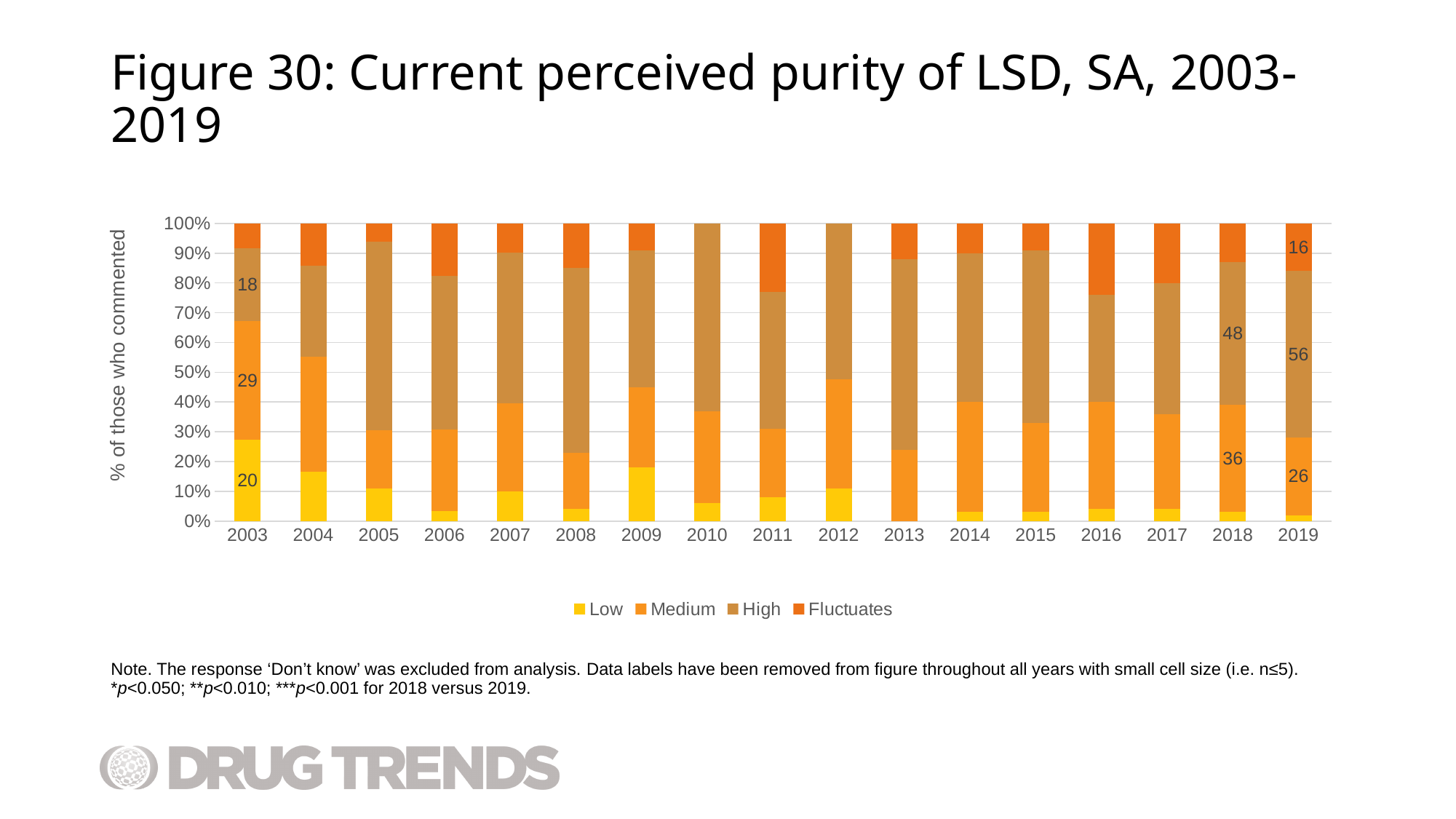
What is the data label on the Medium segment for 2018? 36 What is the data label on the Medium segment for 2003? 29 What is the data label on the Low segment for 2003? 20 Is the top of the Low segment for 2012 greater or less than 20%? less What is the difference between the High data labels for 2019 and 2018? 8 How many years are shown on the x axis? 17 How many series does the legend list? 4 Which has the larger High data label, 2018 or 2019? 2019 What is the data label on the Fluctuates segment for 2019? 16 What is the data label on the High segment for 2019? 56 What kind of chart is shown on the slide? Stacked bar chart What is the y-axis title of the chart? % of those who commented